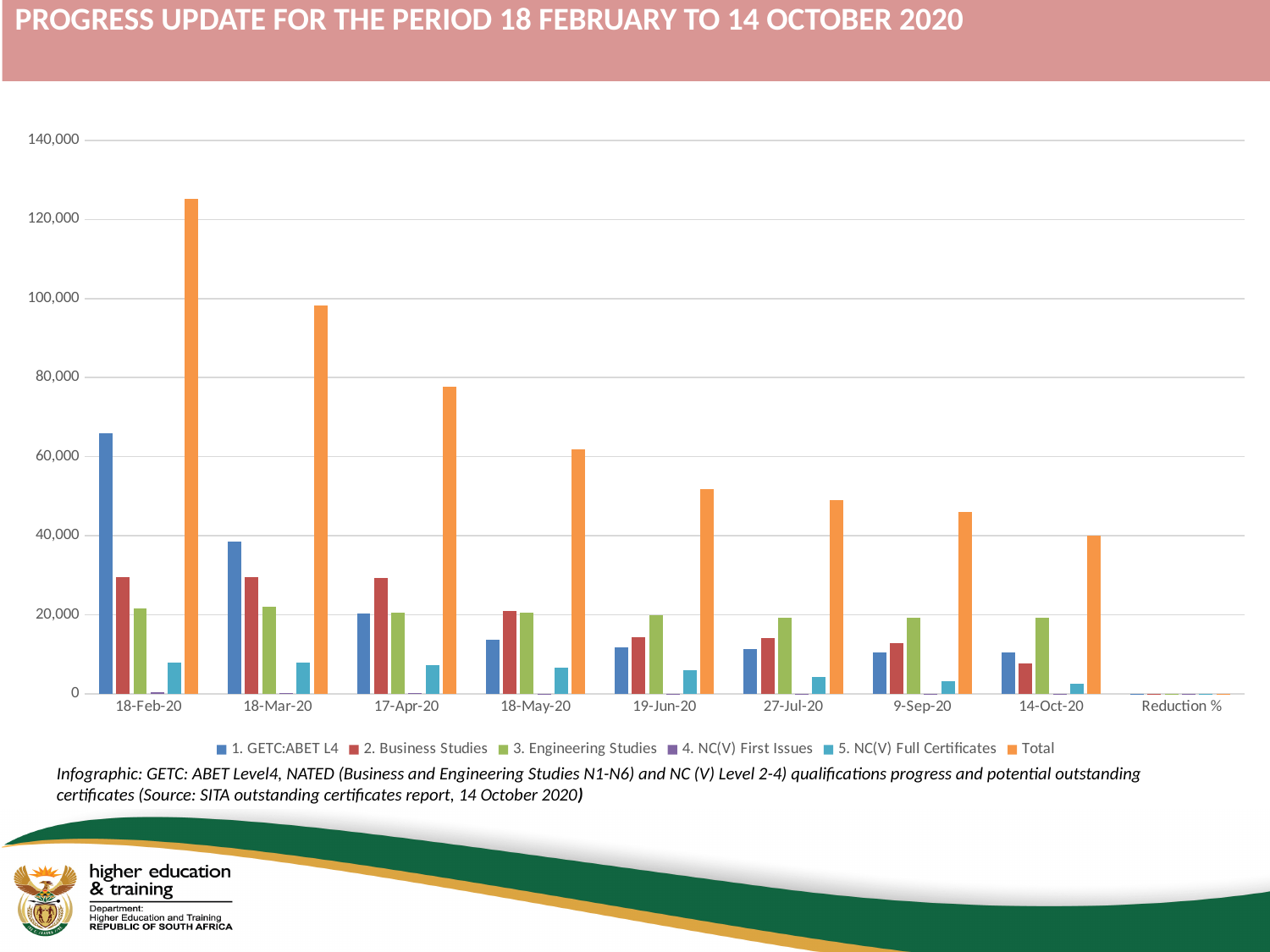
How many series does the legend list? 6 Which series is represented by the orange bars in the legend? Total At 18-Feb-20, which is larger: 2. Business Studies or 3. Engineering Studies? 2. Business Studies What kind of chart is shown on the slide? Bar chart Is the Total value for 18-Feb-20 greater or less than 120,000? greater Is the value for 1. GETC:ABET L4 at 18-Feb-20 greater or less than 60,000? greater At which date is the Total bar highest? 18-Feb-20 At 14-Oct-20, which is larger: 2. Business Studies or 3. Engineering Studies? 3. Engineering Studies Is the Total value for 18-Mar-20 greater or less than 100,000? less How many categories are shown along the x axis? 9 Does the Total series rise or fall from 18-Feb-20 to 14-Oct-20? fall